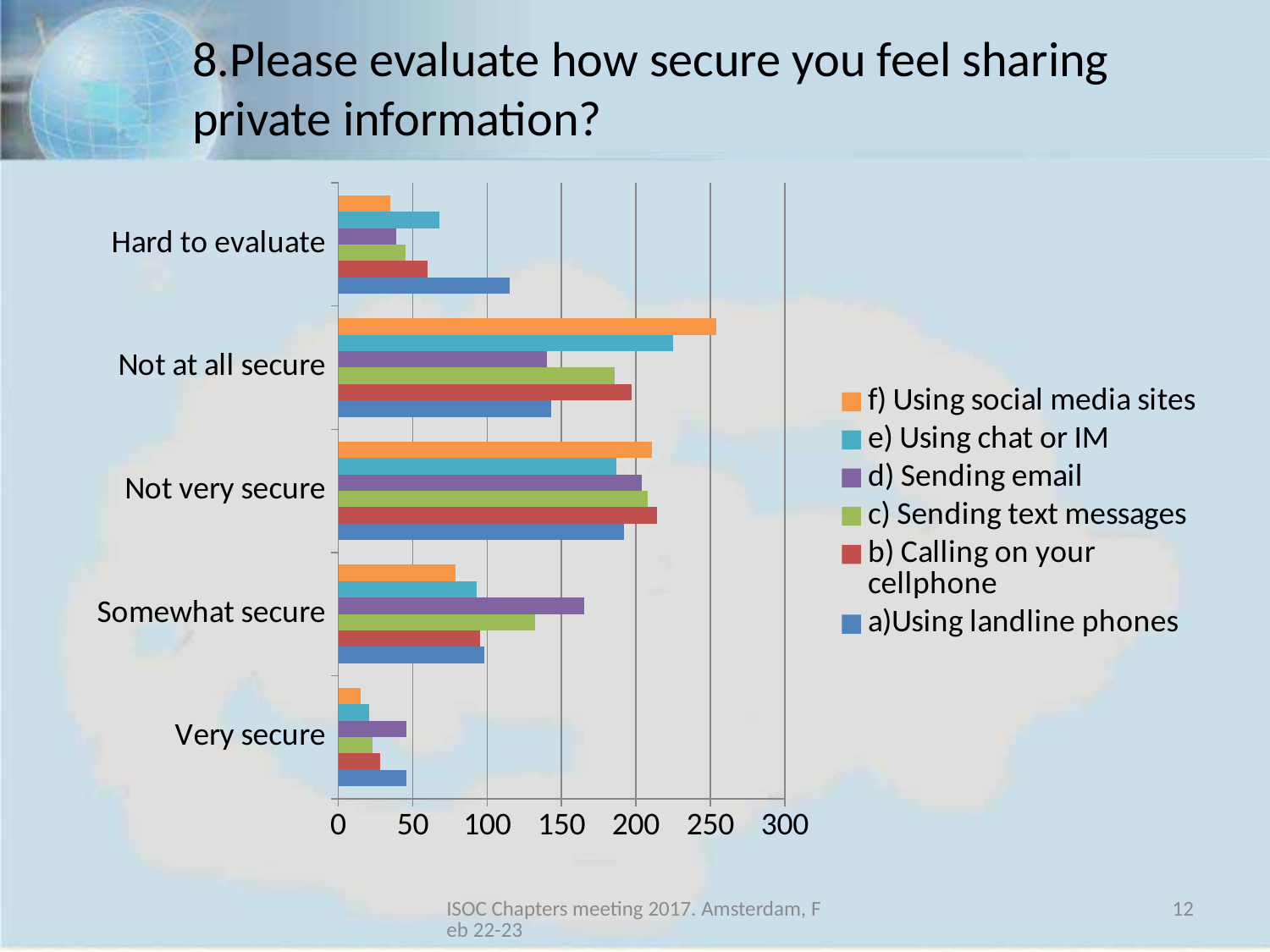
Is the value for 'f) Using social media sites' in the 'Not at all secure' category greater or less than 200? greater How many response categories are shown on the y axis of the chart? 5 Is the value for 'd) Sending email' in the 'Somewhat secure' category greater or less than 150? greater How many series does the chart's legend list? 6 Is the value for 'e) Using chat or IM' in the 'Not at all secure' category greater or less than 200? greater In the 'Hard to evaluate' category, which is larger: 'a)Using landline phones' or 'e) Using chat or IM'? a)Using landline phones In the 'Somewhat secure' category, which is larger: 'd) Sending email' or 'f) Using social media sites'? d) Sending email For 'f) Using social media sites', which response category has the lowest value? Very secure In the 'Somewhat secure' category, which series has the highest value? d) Sending email What kind of chart is shown on the slide? bar chart For 'f) Using social media sites', which response category has the highest value? Not at all secure